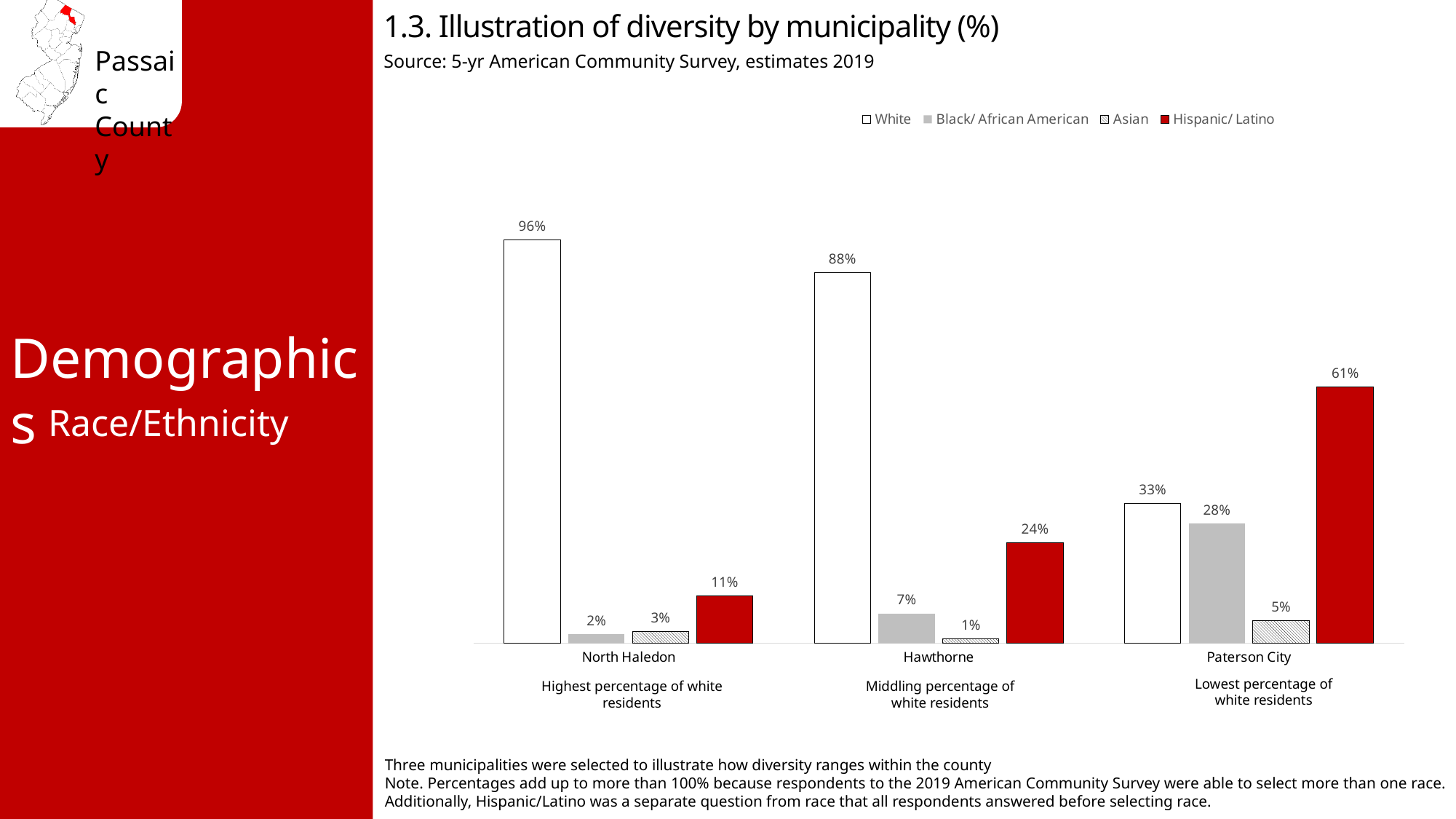
How many municipalities are shown on the chart? 3 What is the difference between the Hispanic/ Latino percentages for Paterson City and Hawthorne? 37% Which municipality has the lowest Asian percentage? Hawthorne What kind of chart is shown on the slide? Bar chart Which municipality has the highest White percentage? North Haledon What is the Hispanic/ Latino percentage for Paterson City? 61% What is the Black/ African American percentage for Hawthorne? 7% What is the Asian percentage for Paterson City? 5% Which is larger for Paterson City: the White percentage or the Black/ African American percentage? White How many series does the legend list? 4 What is the White percentage for North Haledon? 96% What is the source cited for the chart? 5-yr American Community Survey, estimates 2019